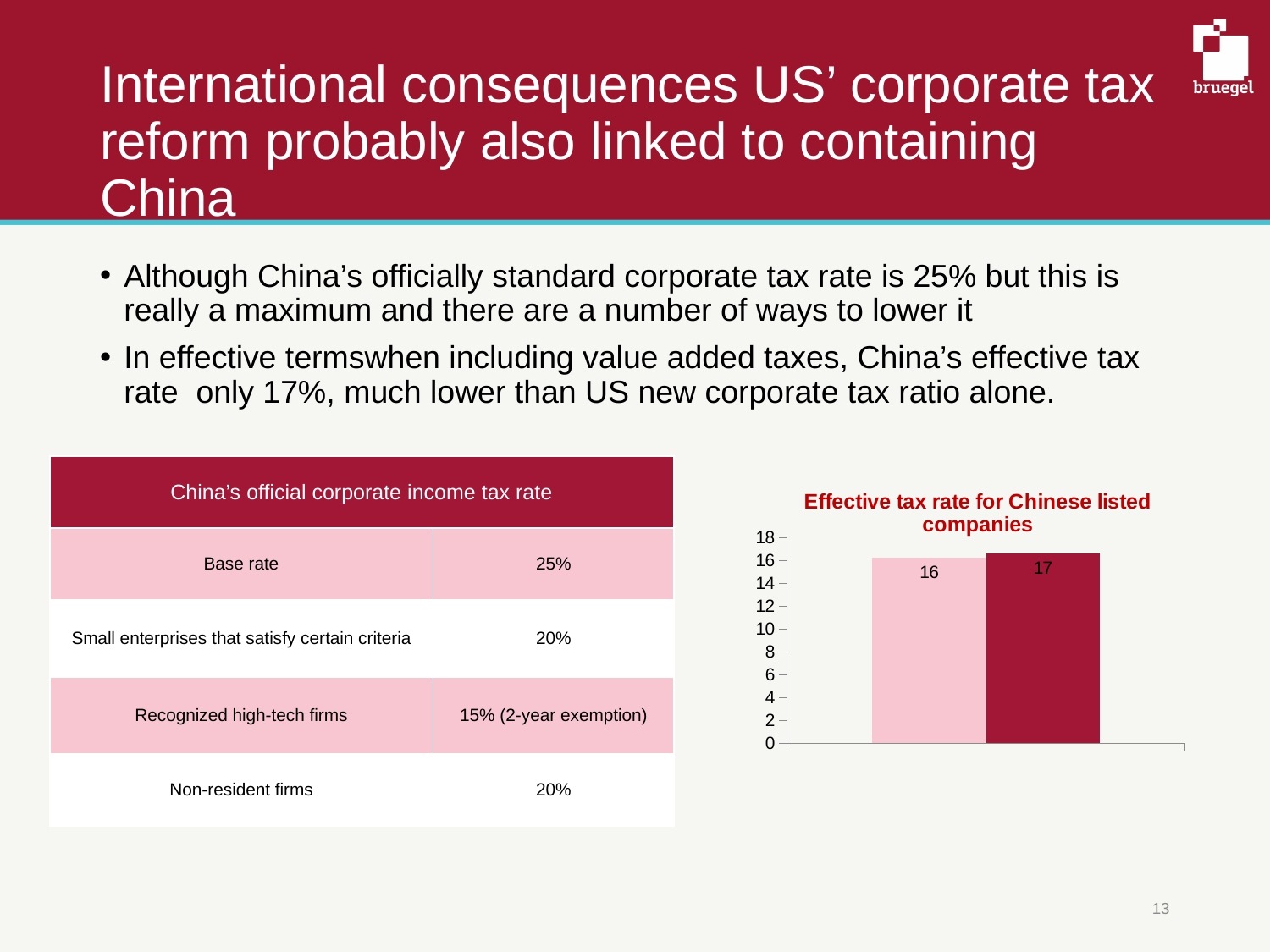
Which is larger, the left bar or the right bar in the chart? the right bar Is the value of the left bar in the chart greater or less than 10? greater What kind of chart is shown on the slide? bar chart What is the value of the left (light pink) bar in the chart? 16 How many bars are plotted in the chart? 2 What is the title of the chart on the slide? Effective tax rate for Chinese listed companies What is the value of the right (dark red) bar in the chart? 17 Which bar in the chart is the highest? the right (dark red) bar What is the highest value shown on the vertical axis of the chart? 18 Which bar in the chart is the lowest? the left (light pink) bar What is the difference between the two bars in the chart? 1 Is the value of the right bar in the chart greater or less than 18? less